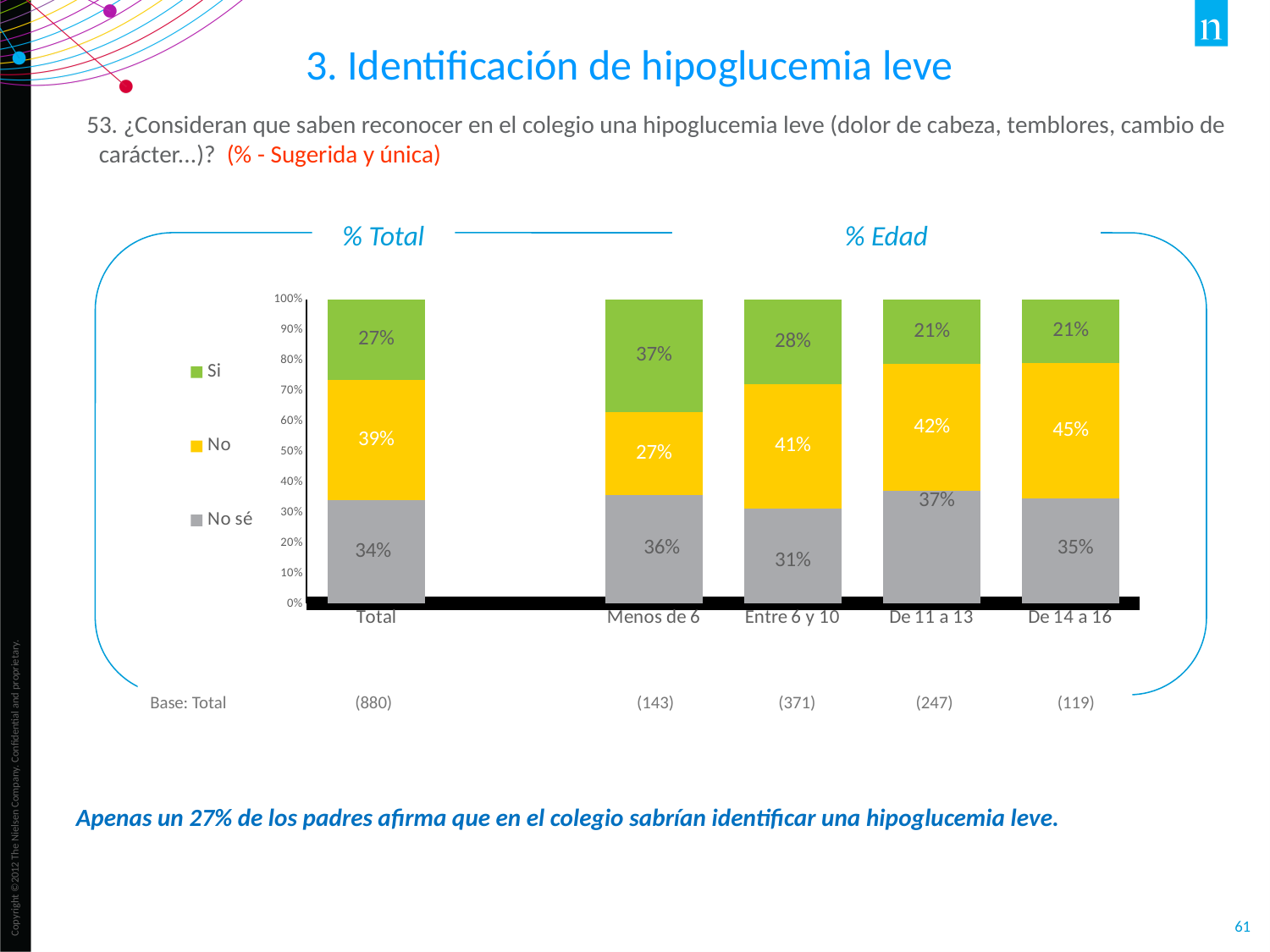
Which age category has the highest value for "Si"? Menos de 6 Which category has the lowest value for "No"? Menos de 6 How many series does the legend list? 3 What is the value for "Si" in the Total bar? 27% What kind of chart is shown on the slide? Stacked bar chart What is the value for "No" in the "De 14 a 16" bar? 45% What is the value for "No sé" in the "Entre 6 y 10" bar? 31% What is the difference between the "No" values for "De 14 a 16" and "Menos de 6"? 18% Which is larger: the "No sé" value for "De 11 a 13" or for "Entre 6 y 10"? De 11 a 13 Which legend entry is shown in yellow? No How many categories are shown on the x axis? 5 What is the value for "Si" in the "Menos de 6" bar? 37%